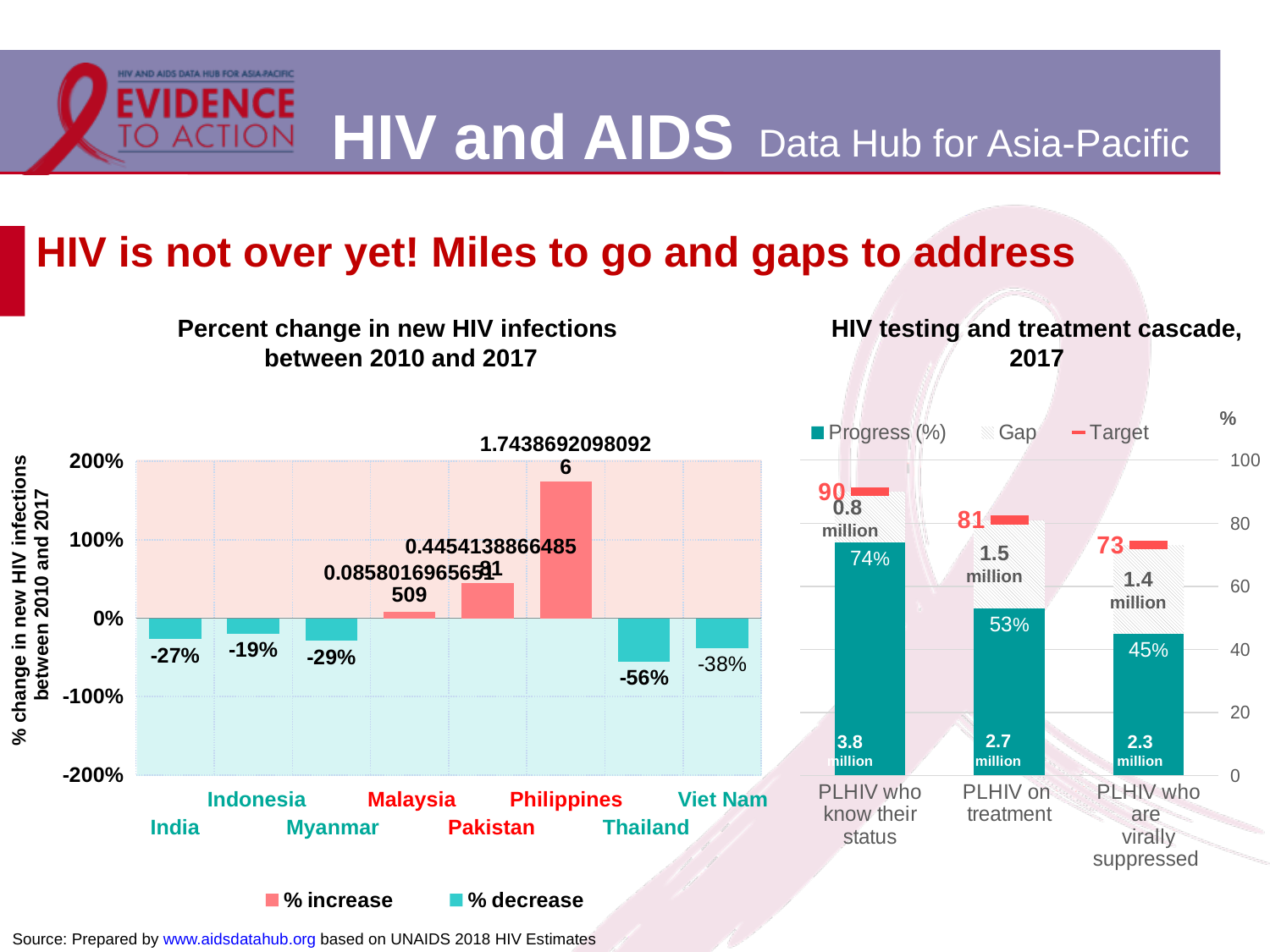
In the 'HIV testing and treatment cascade, 2017' chart, do the progress percentages rise or fall from left to right? fall In the 'Percent change in new HIV infections between 2010 and 2017' chart, what is the difference between the values for Viet Nam and Indonesia? 19 percentage points In the 'Percent change in new HIV infections between 2010 and 2017' chart, what is the value for Thailand? -56% In the 'Percent change in new HIV infections between 2010 and 2017' chart, which country has the highest value? Philippines In the 'Percent change in new HIV infections between 2010 and 2017' chart, how many countries are shown? 8 In the 'HIV testing and treatment cascade, 2017' chart, what is the progress percentage for PLHIV on treatment? 53% In the 'Percent change in new HIV infections between 2010 and 2017' chart, what is the value for India? -27% In the 'Percent change in new HIV infections between 2010 and 2017' chart, which country shows the largest decrease? Thailand In the 'HIV testing and treatment cascade, 2017' chart, how many series does the legend list? 3 In the 'HIV testing and treatment cascade, 2017' chart, what is the target for PLHIV who are virally suppressed? 73 In the 'Percent change in new HIV infections between 2010 and 2017' chart, is the value for Philippines greater or less than 100%? greater In the 'Percent change in new HIV infections between 2010 and 2017' chart, what do the two legend entries say? % increase, % decrease